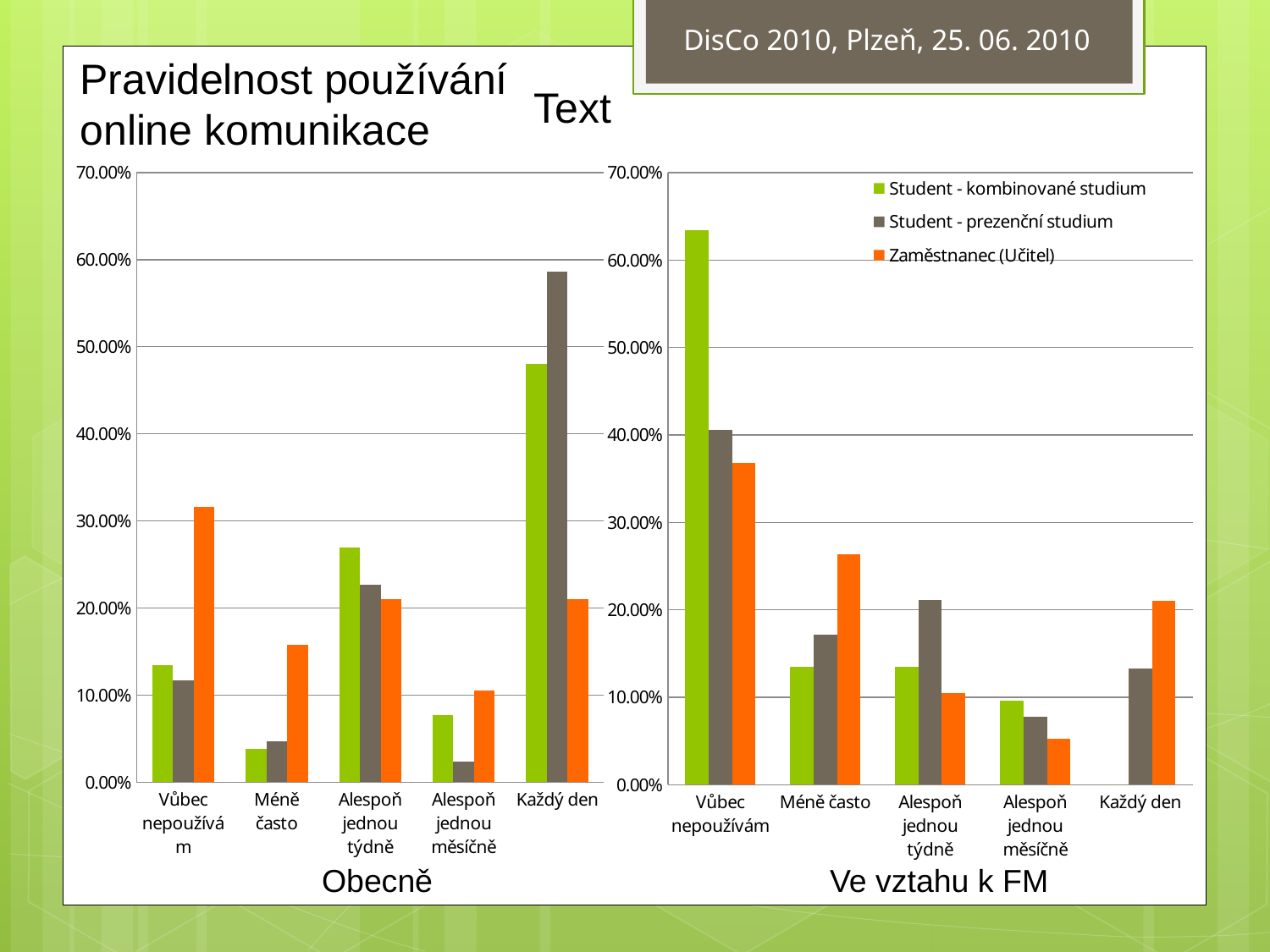
In the 'Obecně' chart, is the value for Zaměstnanec (Učitel) in the 'Vůbec nepoužívám' category greater or less than 30.00%? greater In the 'Obecně' chart, which category has the lowest value for Zaměstnanec (Učitel)? Alespoň jednou měsíčně How many series does the legend list for the charts? 3 In the 'Ve vztahu k FM' chart, which is larger in the 'Méně často' category: Zaměstnanec (Učitel) or Student - kombinované studium? Zaměstnanec (Učitel) In the 'Obecně' chart, is the value for Student - prezenční studium in the 'Každý den' category greater or less than 50.00%? greater What kind of chart is the 'Obecně' chart on the left? bar chart In the 'Ve vztahu k FM' chart, which category has the highest value for Student - kombinované studium? Vůbec nepoužívám How many categories are shown on the x axis of the 'Ve vztahu k FM' chart? 5 In the 'Obecně' chart, which category has the highest value for Student - prezenční studium? Každý den Which colour represents Zaměstnanec (Učitel) in the legend? orange In the 'Obecně' chart, which is larger in the 'Každý den' category: Student - kombinované studium or Zaměstnanec (Učitel)? Student - kombinované studium In the 'Ve vztahu k FM' chart, is the value for Student - kombinované studium in the 'Vůbec nepoužívám' category greater or less than 60.00%? greater